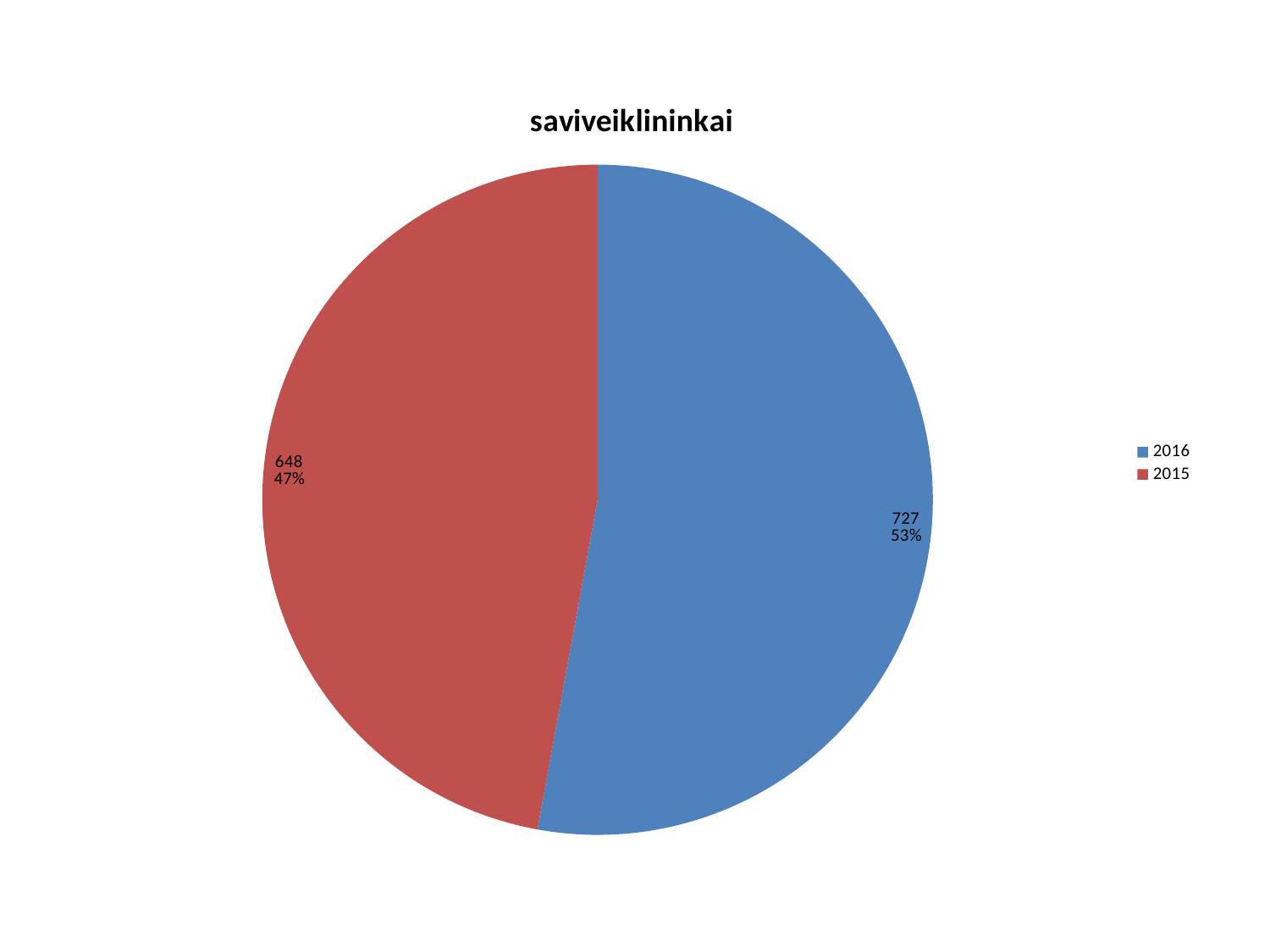
Which year has the larger slice in the saviveiklininkai pie chart? 2016 What is the title of the chart on the slide? saviveiklininkai Which year has the smaller slice in the saviveiklininkai pie chart? 2015 What share of the saviveiklininkai pie does 2016 represent? 53% Is the value for 2016 larger or smaller than the value for 2015 in the saviveiklininkai pie chart? larger What is the total of the two values shown in the saviveiklininkai pie chart? 1375 What is the value for 2016 in the saviveiklininkai pie chart? 727 How many slices does the saviveiklininkai pie chart have? 2 What is the difference between the 2016 and 2015 values in the saviveiklininkai pie chart? 79 What is the value for 2015 in the saviveiklininkai pie chart? 648 What share of the saviveiklininkai pie does 2015 represent? 47% What kind of chart is shown on the slide? pie chart